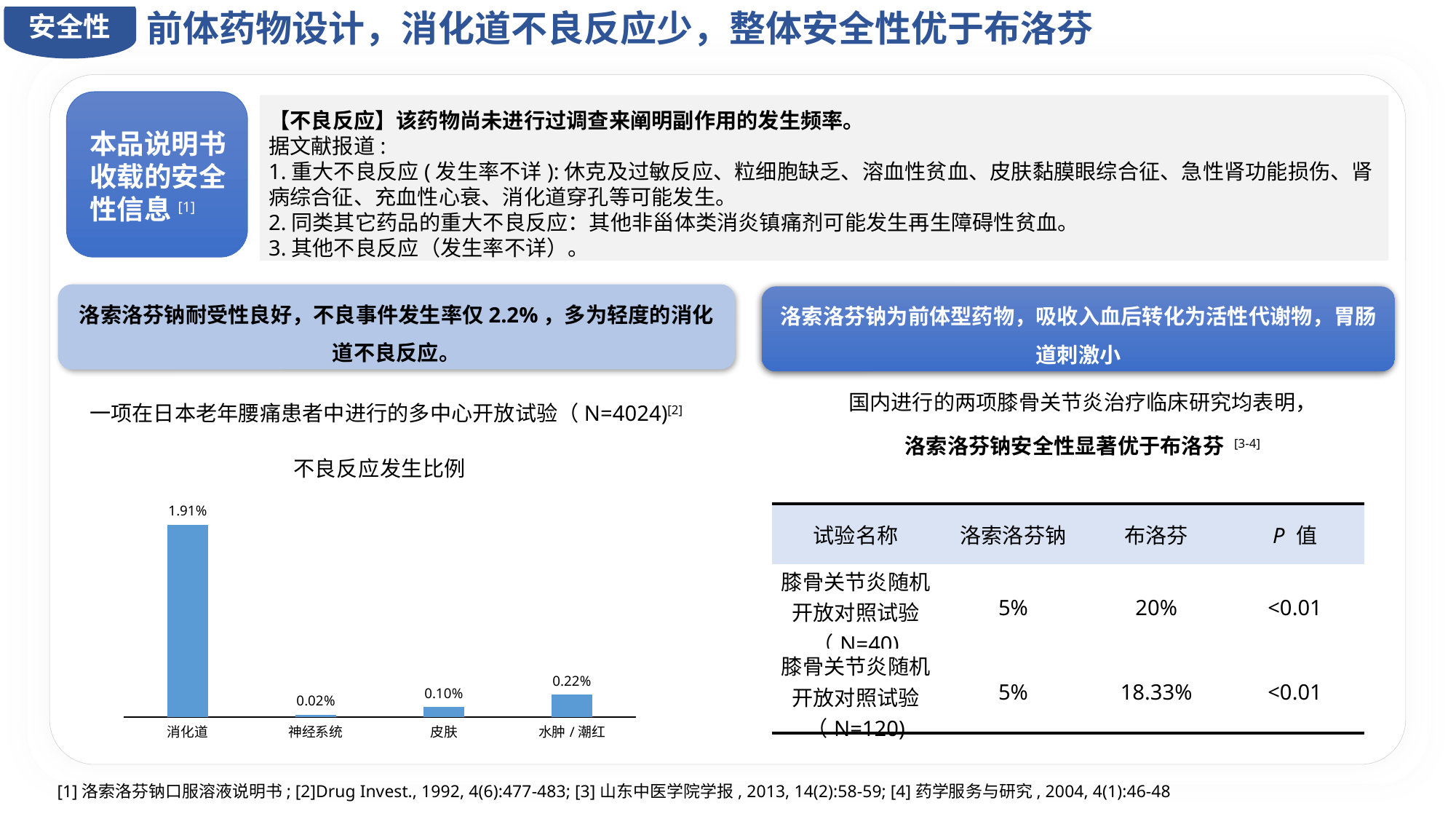
Which category has the lowest value in the 不良反应发生比例 chart? 神经系统 What is the title of the chart on the slide? 不良反应发生比例 What is the difference between the values for 水肿 / 潮红 and 皮肤 in the 不良反应发生比例 chart? 0.12% What is the value for 皮肤 in the 不良反应发生比例 chart? 0.10% What kind of chart is the 不良反应发生比例 chart? bar chart What is the value for 水肿 / 潮红 in the 不良反应发生比例 chart? 0.22% What is the value for 神经系统 in the 不良反应发生比例 chart? 0.02% Which is larger in the 不良反应发生比例 chart, the value for 皮肤 or the value for 水肿 / 潮红? 水肿 / 潮红 How many categories are shown in the 不良反应发生比例 chart? 4 Which category has the highest value in the 不良反应发生比例 chart? 消化道 What is the difference between the values for 消化道 and 水肿 / 潮红 in the 不良反应发生比例 chart? 1.69% What is the value for 消化道 in the 不良反应发生比例 chart? 1.91%